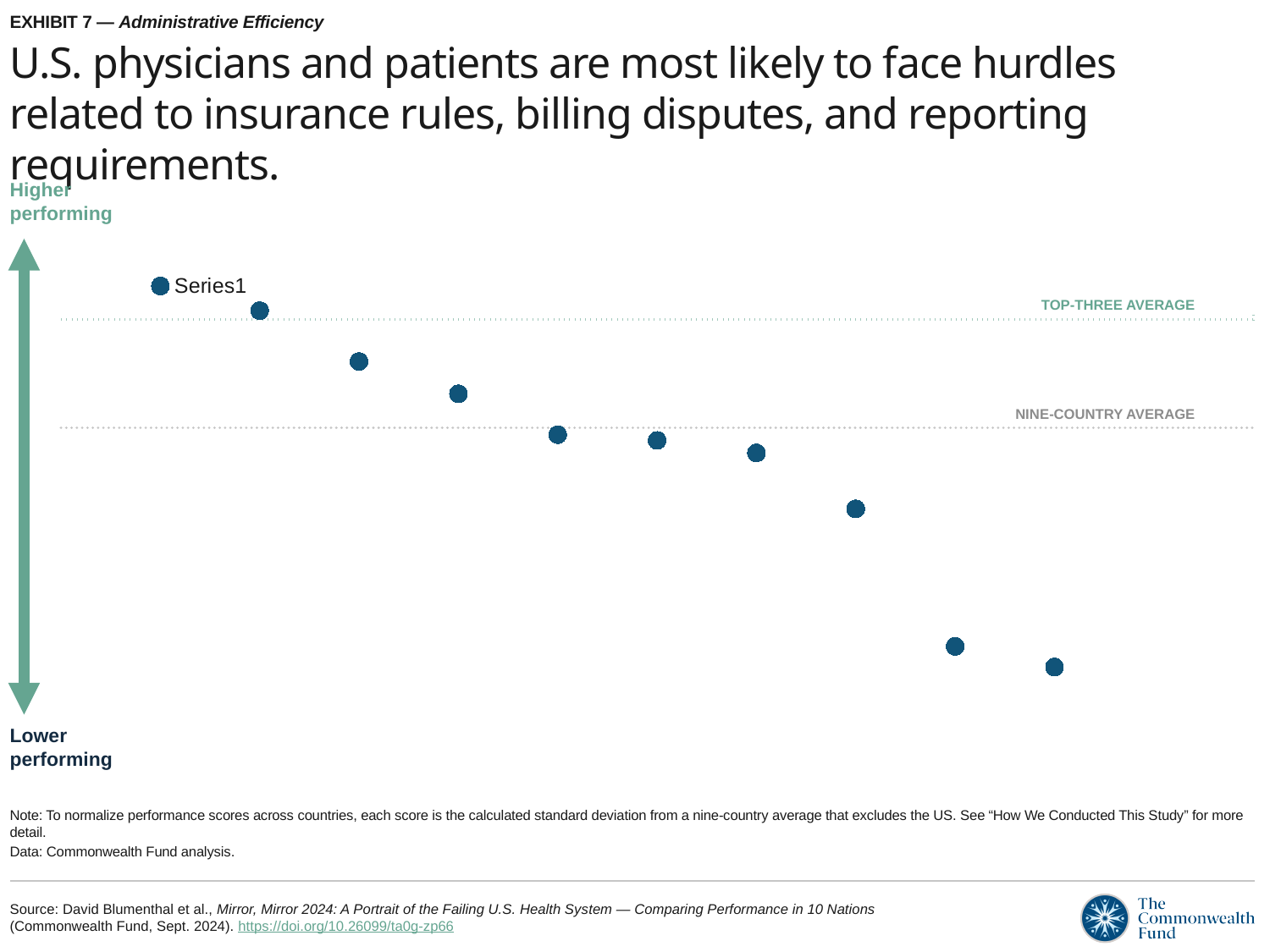
What kind of chart is shown on the slide? scatter (dot) chart Do the plotted values rise or fall moving from left to right across the chart? fall Is the leftmost data point above or below the TOP-THREE AVERAGE line? above Is the rightmost data point above or below the NINE-COUNTRY AVERAGE line? below Which data point is the lowest on the chart, the leftmost or the rightmost? rightmost How many data points are plotted on the chart? 10 How many data points lie above the TOP-THREE AVERAGE line? 2 Which data point is the highest on the chart, the leftmost or the rightmost? leftmost What are the two reference lines on the chart labelled? TOP-THREE AVERAGE and NINE-COUNTRY AVERAGE